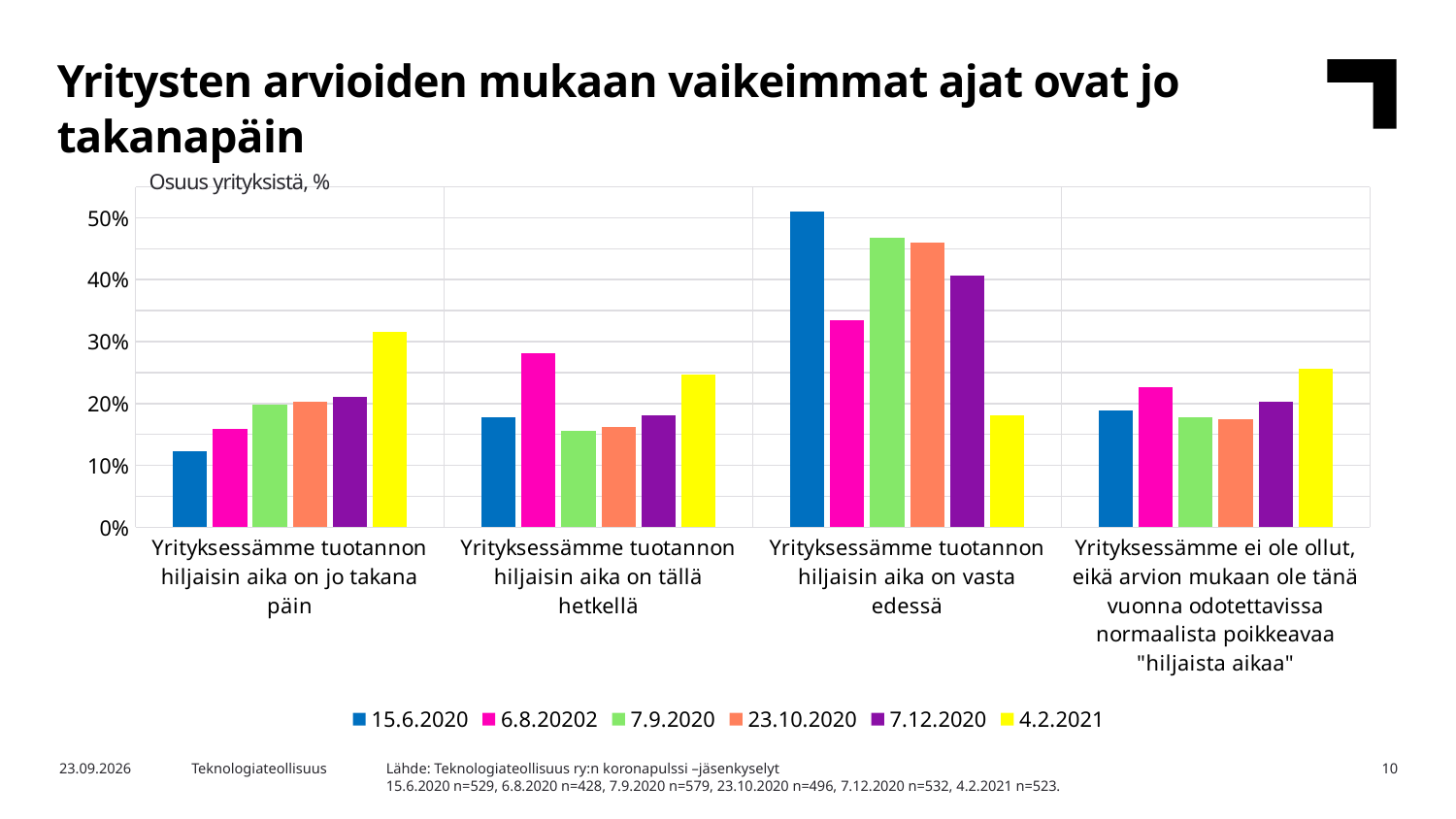
Which category has the highest bar for the 15.6.2020 series? Yrityksessämme tuotannon hiljaisin aika on vasta edessä For the category "Yrityksessämme tuotannon hiljaisin aika on vasta edessä", do the values overall rise or fall from 15.6.2020 to 4.2.2021? fall What kind of chart is shown on the slide? bar chart How many categories are shown on the x axis? 4 Is the 4.2.2021 value for "Yrityksessämme tuotannon hiljaisin aika on jo takana päin" greater or less than 30%? greater Which series has the lowest bar in the category "Yrityksessämme tuotannon hiljaisin aika on jo takana päin"? 15.6.2020 In the category "Yrityksessämme tuotannon hiljaisin aika on tällä hetkellä", which is larger: the 6.8.20202 value or the 7.9.2020 value? 6.8.20202 What colour represents the 4.2.2021 series in the chart? yellow Is the 15.6.2020 value for "Yrityksessämme tuotannon hiljaisin aika on vasta edessä" greater or less than 40%? greater Is the 4.2.2021 value for "Yrityksessämme tuotannon hiljaisin aika on vasta edessä" greater or less than 20%? less How many series does the legend list? 6 What is the label shown above the y axis of the chart? Osuus yrityksistä, %